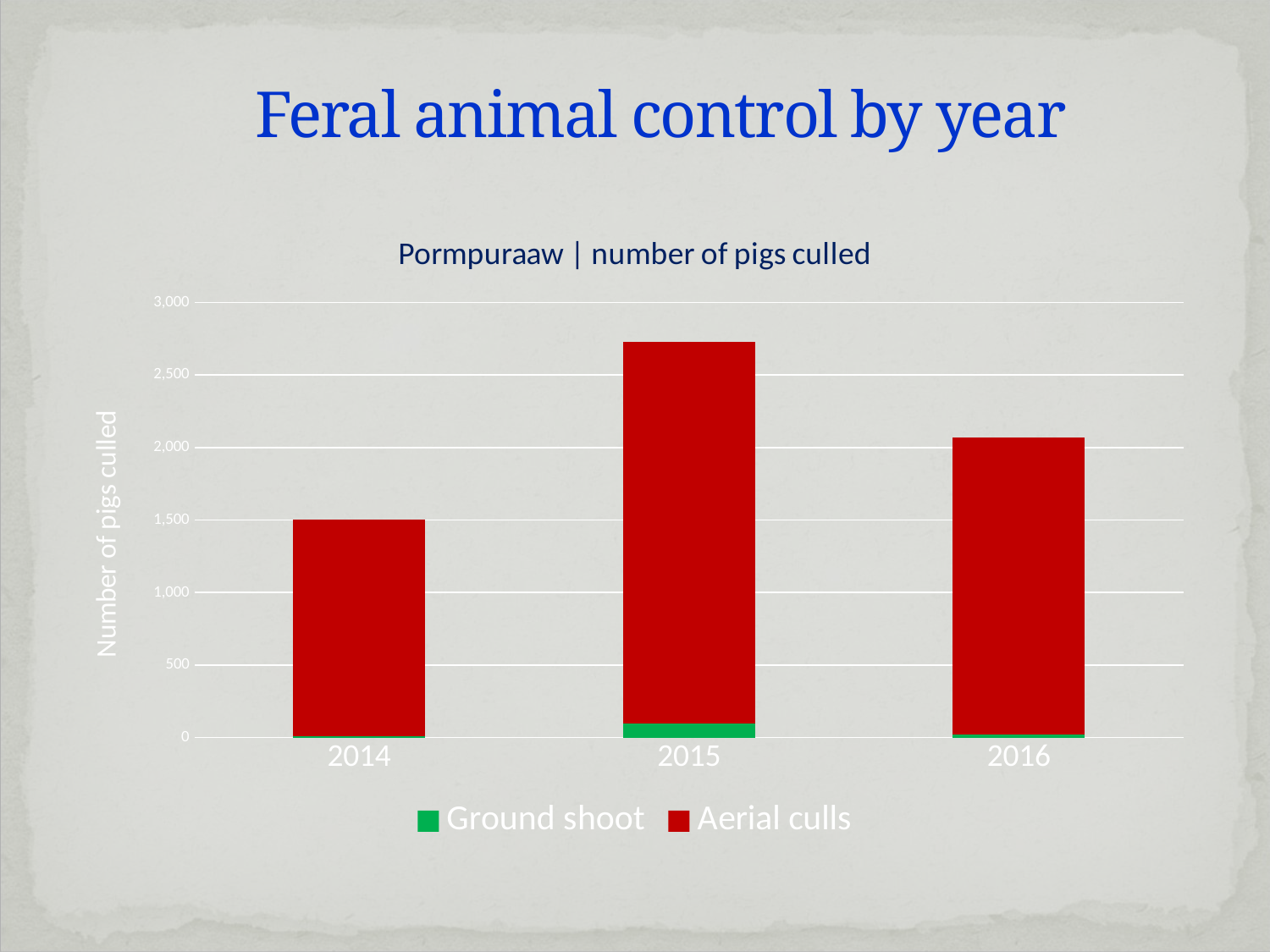
Is the total number of pigs culled in 2016 greater or less than 2,500? less Which series is shown in red? Aerial culls Which year has the highest total number of pigs culled? 2015 How many series does the legend list? 2 How many years are shown on the x axis? 3 What is the title of the chart? Pormpuraaw | number of pigs culled Which year has the larger total number of pigs culled, 2015 or 2016? 2015 Is the total number of pigs culled in 2014 greater or less than 2,000? less Which year has the lowest total number of pigs culled? 2014 Which series accounts for the larger share of the 2015 bar, Ground shoot or Aerial culls? Aerial culls What kind of chart is shown on the slide? bar chart Is the total number of pigs culled in 2015 greater or less than 2,500? greater